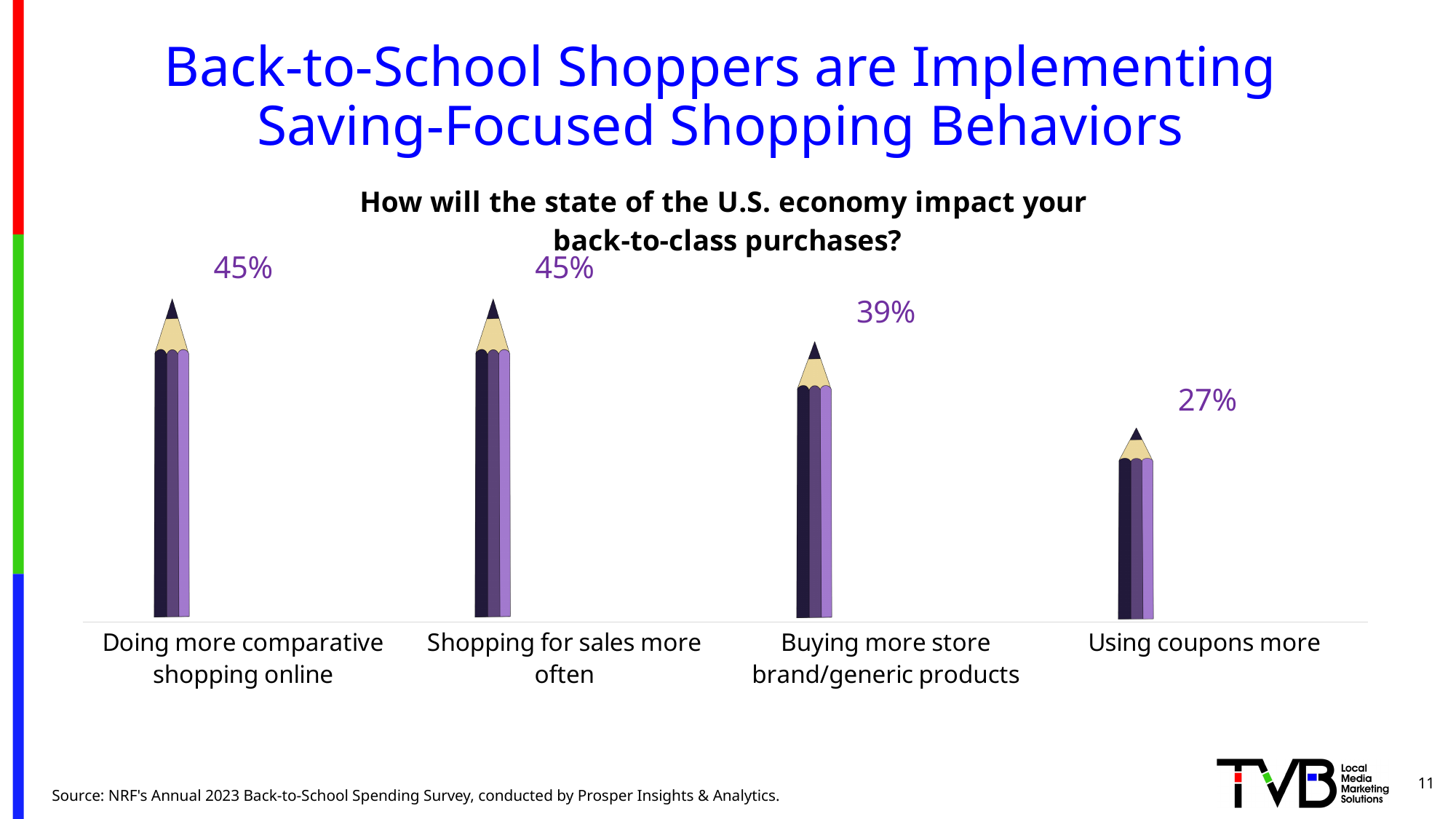
What is the value for 'Shopping for sales more often'? 45% Which category has the lowest value? Using coupons more What is the value for 'Using coupons more'? 27% What question is the chart titled with? How will the state of the U.S. economy impact your back-to-class purchases? What is the difference between 'Shopping for sales more often' and 'Buying more store brand/generic products'? 6% Do the values rise or fall from left to right across the categories? Fall What percentage of shoppers are buying more store brand/generic products? 39% How many categories are shown in the chart? 4 What percentage of shoppers say they are doing more comparative shopping online? 45% What is the difference between 'Buying more store brand/generic products' and 'Using coupons more'? 12% What kind of chart is shown on the slide? Bar chart Which is larger: 'Buying more store brand/generic products' or 'Using coupons more'? Buying more store brand/generic products